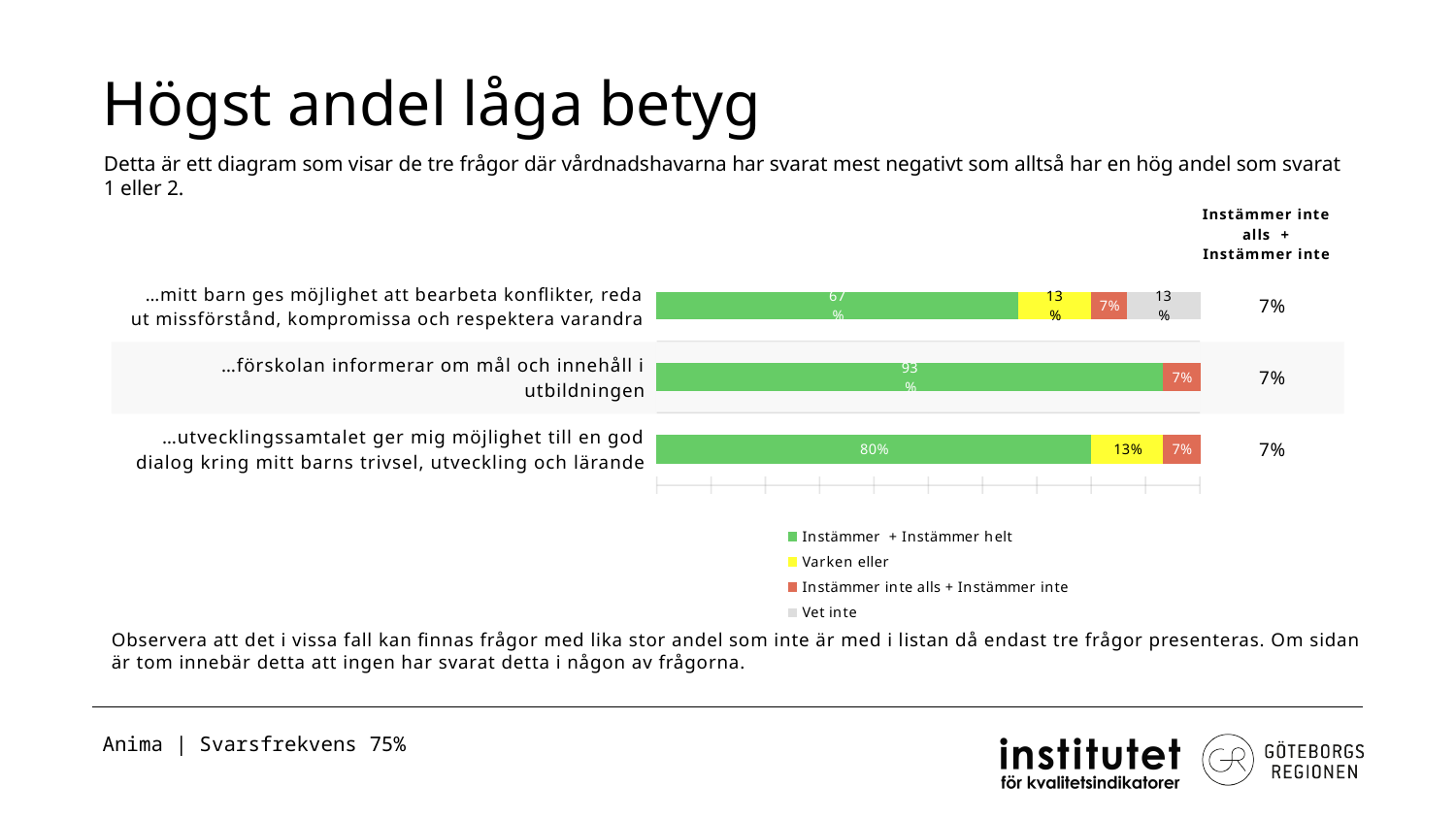
What is the value of 'Instämmer + Instämmer helt' for '…utvecklingssamtalet ger mig möjlighet till en god dialog kring mitt barns trivsel, utveckling och lärande'? 80% What is the difference between the 'Instämmer + Instämmer helt' values for '…förskolan informerar om mål och innehåll i utbildningen' and '…utvecklingssamtalet ger mig möjlighet till en god dialog kring mitt barns trivsel, utveckling och lärande'? 13% What is the value of 'Instämmer + Instämmer helt' for '…förskolan informerar om mål och innehåll i utbildningen'? 93% How many series does the legend list? 4 Which category has the highest 'Instämmer + Instämmer helt' value? …förskolan informerar om mål och innehåll i utbildningen What is the 'Vet inte' value for '…mitt barn ges möjlighet att bearbeta konflikter, reda ut missförstånd, kompromissa och respektera varandra'? 13% How many categories (questions) are plotted in the chart? 3 What kind of chart is shown on the slide? stacked bar chart What is the title of the slide containing the chart? Högst andel låga betyg Which category has the lowest 'Instämmer + Instämmer helt' value? …mitt barn ges möjlighet att bearbeta konflikter, reda ut missförstånd, kompromissa och respektera varandra What value is shown in the 'Instämmer inte alls + Instämmer inte' column for '…utvecklingssamtalet ger mig möjlighet till en god dialog kring mitt barns trivsel, utveckling och lärande'? 7% What is the value of 'Varken eller' for '…mitt barn ges möjlighet att bearbeta konflikter, reda ut missförstånd, kompromissa och respektera varandra'? 13%